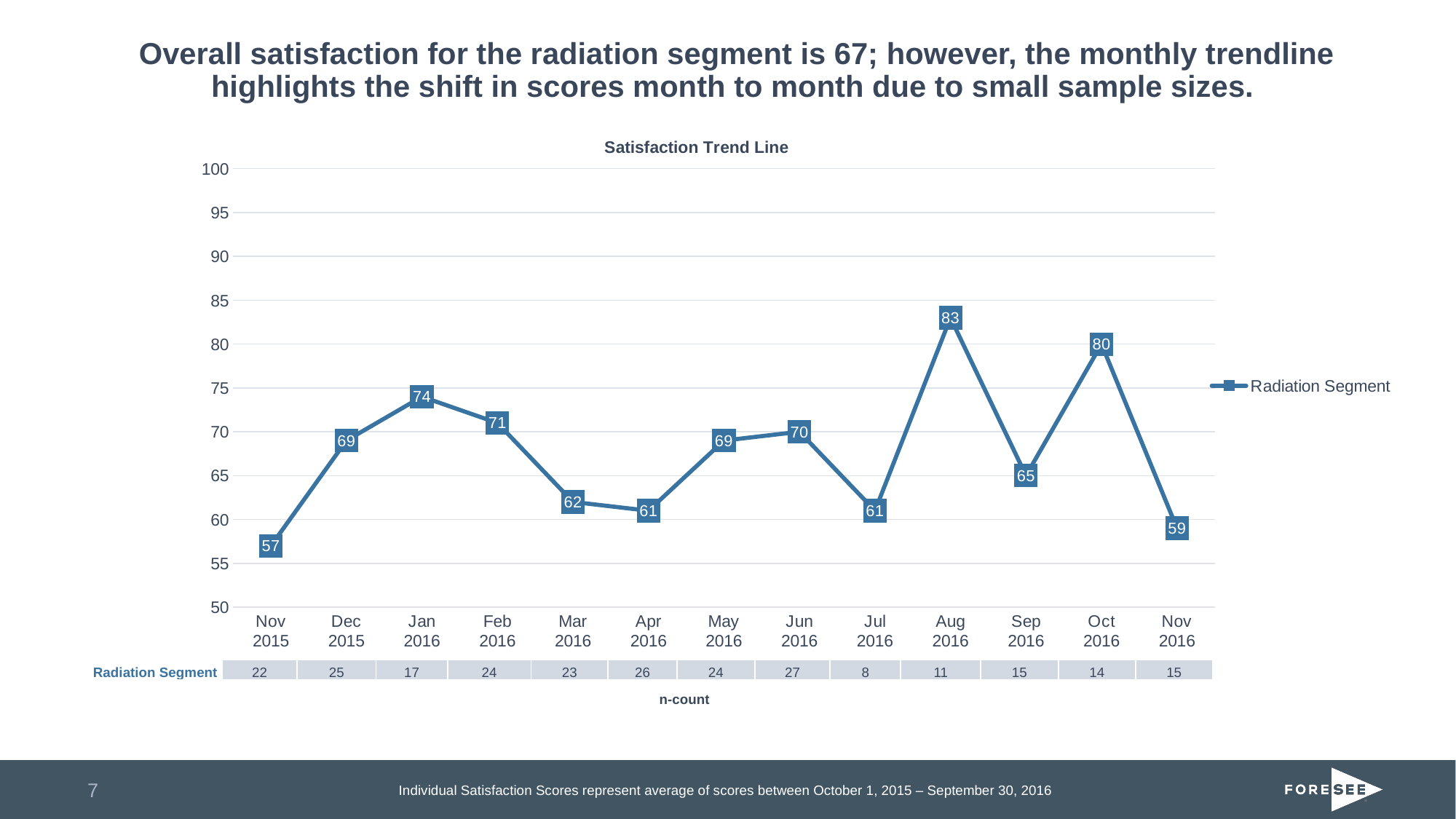
What kind of chart is the Satisfaction Trend Line? Line chart What is the difference between the satisfaction scores for Aug 2016 and Sep 2016? 18 What is the title of the chart on the slide? Satisfaction Trend Line What is the satisfaction score for the Radiation Segment in Jan 2016? 74 What is the satisfaction score for the Radiation Segment in Aug 2016? 83 Which month has the lowest satisfaction score on the Satisfaction Trend Line chart? Nov 2015 Which month has a higher satisfaction score, Oct 2016 or Nov 2016? Oct 2016 How many months are plotted on the Satisfaction Trend Line chart? 13 What is the satisfaction score for the Radiation Segment in Nov 2015? 57 How many series does the legend of the Satisfaction Trend Line chart list? 1 Which month has the highest satisfaction score on the Satisfaction Trend Line chart? Aug 2016 Does the satisfaction score rise or fall from Oct 2016 to Nov 2016? Fall